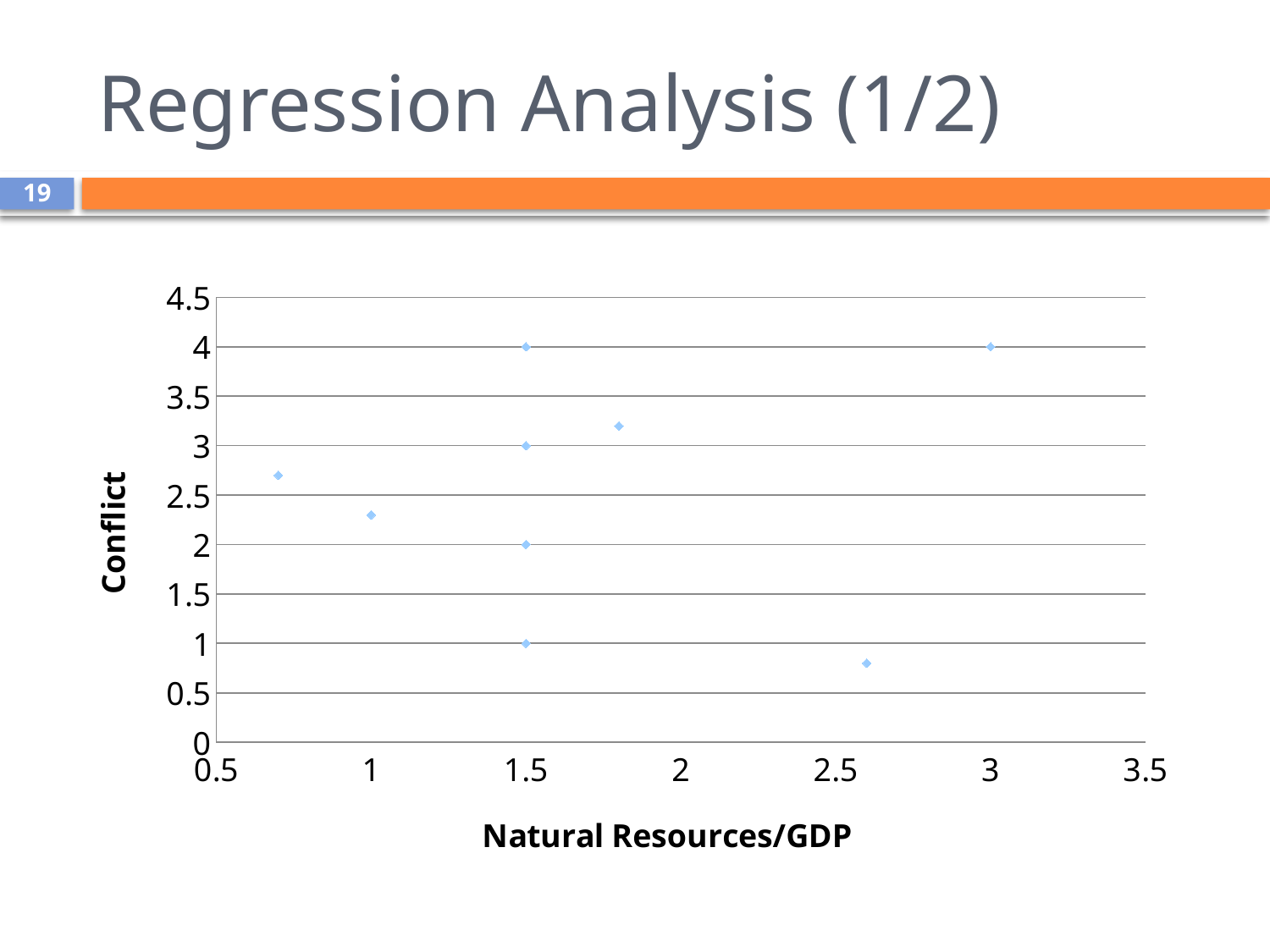
Is the Conflict value of the point near Natural Resources/GDP = 2.6 greater or less than 1? less What kind of chart is shown on the slide? scatter chart How many points are plotted at Natural Resources/GDP = 1.5? 4 What is the highest Conflict value among the points at Natural Resources/GDP = 1.5? 4 Which has the higher Conflict value: the point at Natural Resources/GDP = 3 or the point near Natural Resources/GDP = 2.6? the point at 3 How many data points are plotted on the chart? 9 What is the lowest Conflict value among the points at Natural Resources/GDP = 1.5? 1 What is the title of the horizontal axis? Natural Resources/GDP What is the Conflict value of the point at Natural Resources/GDP = 3? 4 Is the Conflict value of the leftmost point (near Natural Resources/GDP = 0.7) greater or less than 2.5? greater What is the highest Conflict value reached by any point on the chart? 4 What is the title of the vertical axis? Conflict